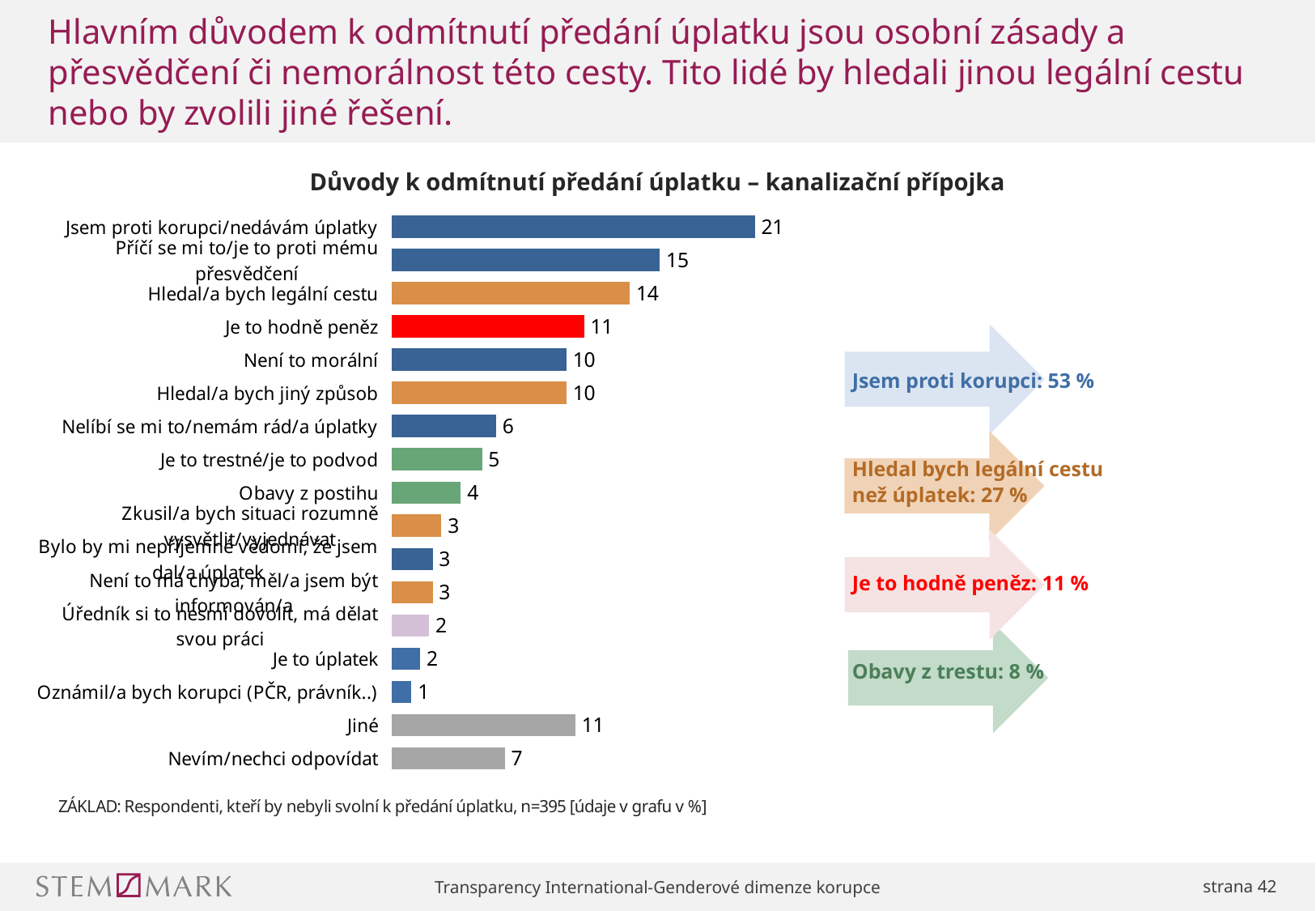
How many categories are shown in the chart? 17 What colour is the bar for "Je to hodně peněz"? Red Which is larger, "Je to trestné/je to podvod" or "Obavy z postihu"? Je to trestné/je to podvod Which category has the highest value? Jsem proti korupci/nedávám úplatky What is the title of the chart? Důvody k odmítnutí předání úplatku – kanalizační přípojka What kind of chart is shown on the slide? Bar chart What is the value for "Nevím/nechci odpovídat"? 7 What is the value for "Jsem proti korupci/nedávám úplatky"? 21 What is the value for "Hledal/a bych legální cestu"? 14 What is the value for "Je to hodně peněz"? 11 Which category has the lowest value? Oznámil/a bych korupci (PČR, právník..) What is the difference between "Jsem proti korupci/nedávám úplatky" and "Příčí se mi to/je to proti mému přesvědčení"? 6